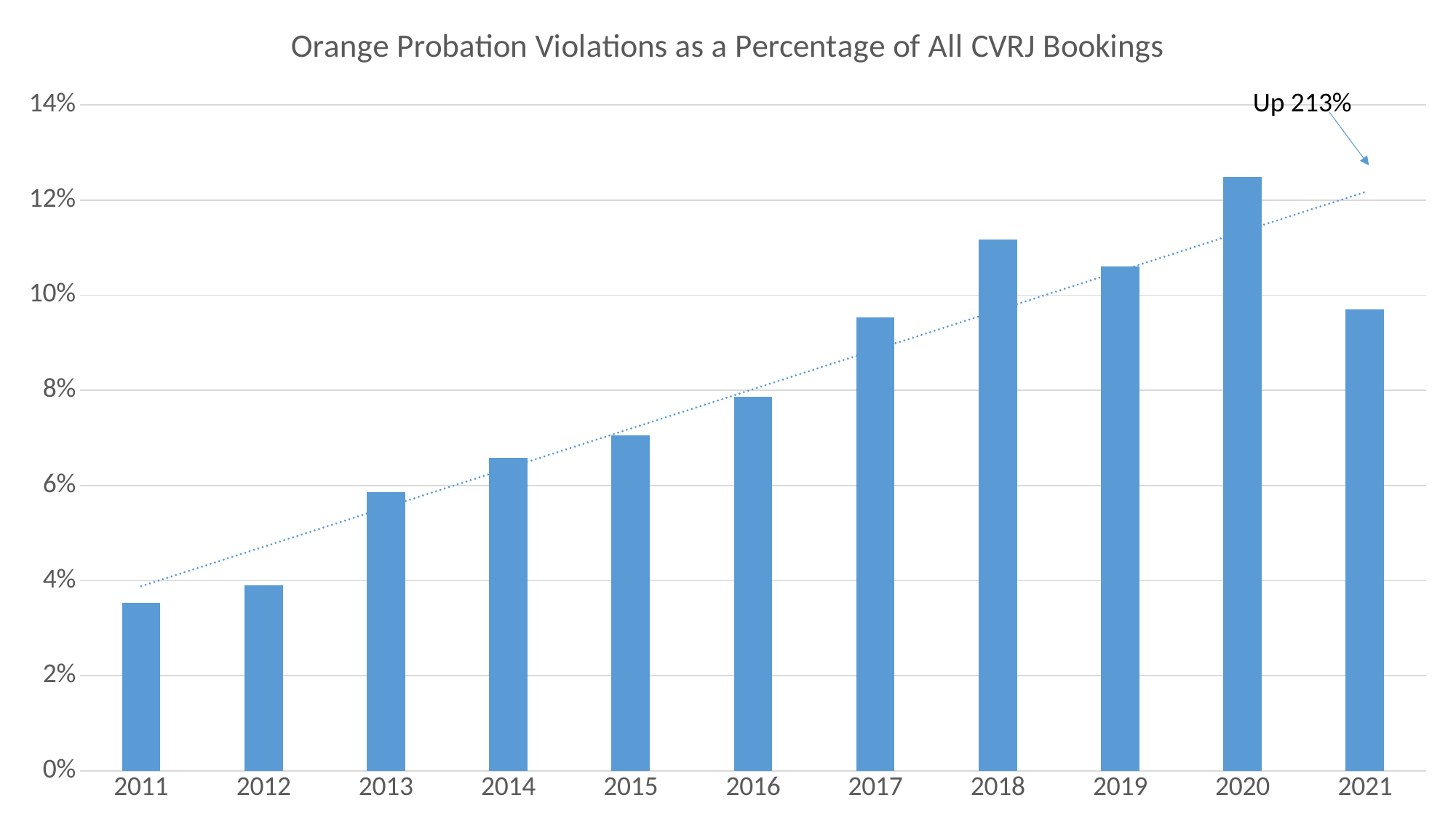
Is the value for 2011 greater or less than 4%? less Do the values generally rise or fall from 2011 to 2020? Rise Which year has the lowest percentage of probation violations? 2011 Which year has a higher value, 2020 or 2021? 2020 Is the value for 2017 greater or less than 10%? less What is the title of the chart? Orange Probation Violations as a Percentage of All CVRJ Bookings Is the value for 2018 greater or less than 10%? greater How many years are shown on the x axis of the chart? 11 What type of chart is shown on the slide? Bar chart Which year has the highest percentage of probation violations? 2020 What percentage increase does the annotation near the trend line state? Up 213%